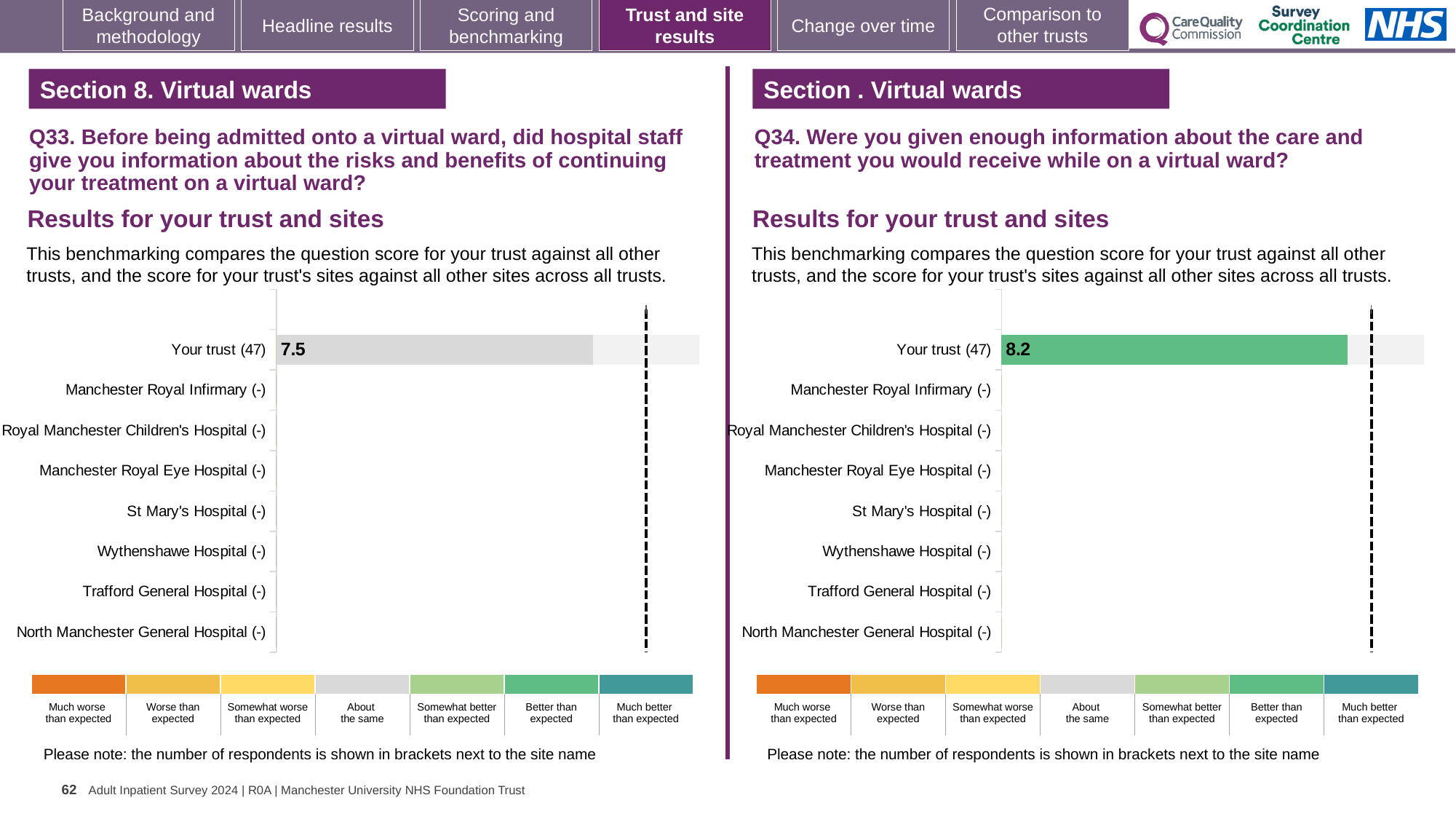
On the Q33 chart (left), how many of the listed sites have a plotted bar? 1 Which is larger: the Your trust score on the Q33 chart (left) or on the Q34 chart (right)? Q34 chart (right) On the Q33 chart (left), which benchmark category does the colour of the Your trust bar correspond to? About the same On the Q34 chart (right), which benchmark category does the colour of the Your trust bar correspond to? Better than expected What kind of chart is the Q33 chart (left)? Bar chart On the Q34 chart (right), what is the score for Your trust? 8.2 On the Q33 chart (left), how many respondents are shown in brackets for Your trust? 47 On the Q34 chart (right), how many rows (categories) are listed on the vertical axis? 8 On the Q34 chart (right), how many respondents are shown in brackets for Your trust? 47 What is the difference between the Your trust score on the Q34 chart (right) and on the Q33 chart (left)? 0.7 On the Q33 chart (left), how many rows (categories) are listed on the vertical axis? 8 On the Q33 chart (left), what is the score for Your trust? 7.5